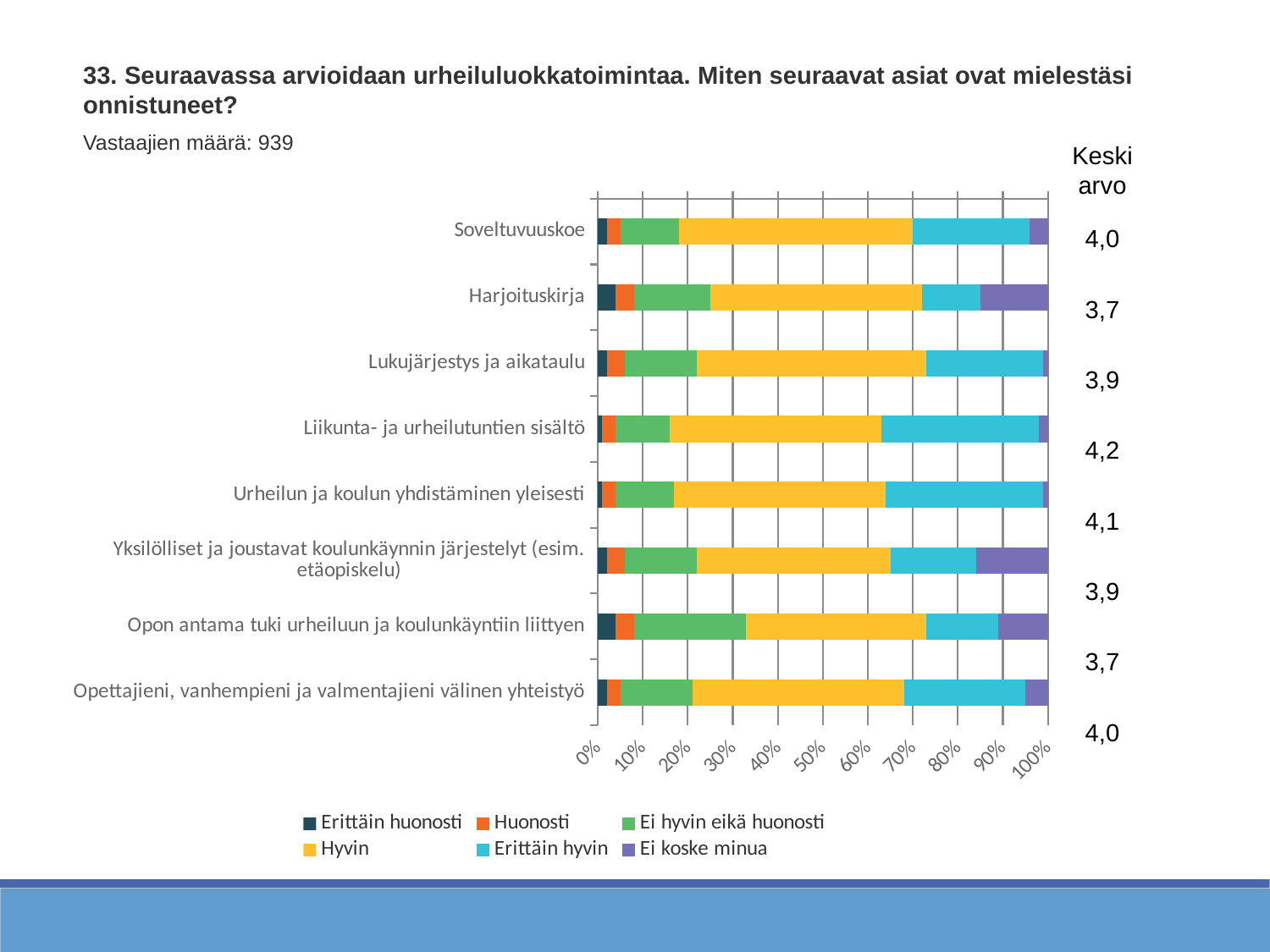
Is the Ei koske minua share for Harjoituskirja greater or less than 10%? greater How many respondents (Vastaajien määrä) does the slide report? 939 Which has the lower Keskiarvo, Soveltuvuuskoe or Harjoituskirja? Harjoituskirja What kind of chart is shown on the slide? Stacked bar chart What is the difference between the Keskiarvo of Liikunta- ja urheilutuntien sisältö and that of Opon antama tuki urheiluun ja koulunkäyntiin liittyen? 0,5 What is the Keskiarvo (mean) shown for Liikunta- ja urheilutuntien sisältö? 4,2 How many series does the legend list? 6 Which series is shown in yellow in the legend? Hyvin Which item has the highest Keskiarvo? Liikunta- ja urheilutuntien sisältö What is the Keskiarvo shown for Harjoituskirja? 3,7 How many categories (items) are plotted on the chart? 8 Is the Ei koske minua share for Lukujärjestys ja aikataulu greater or less than 10%? less